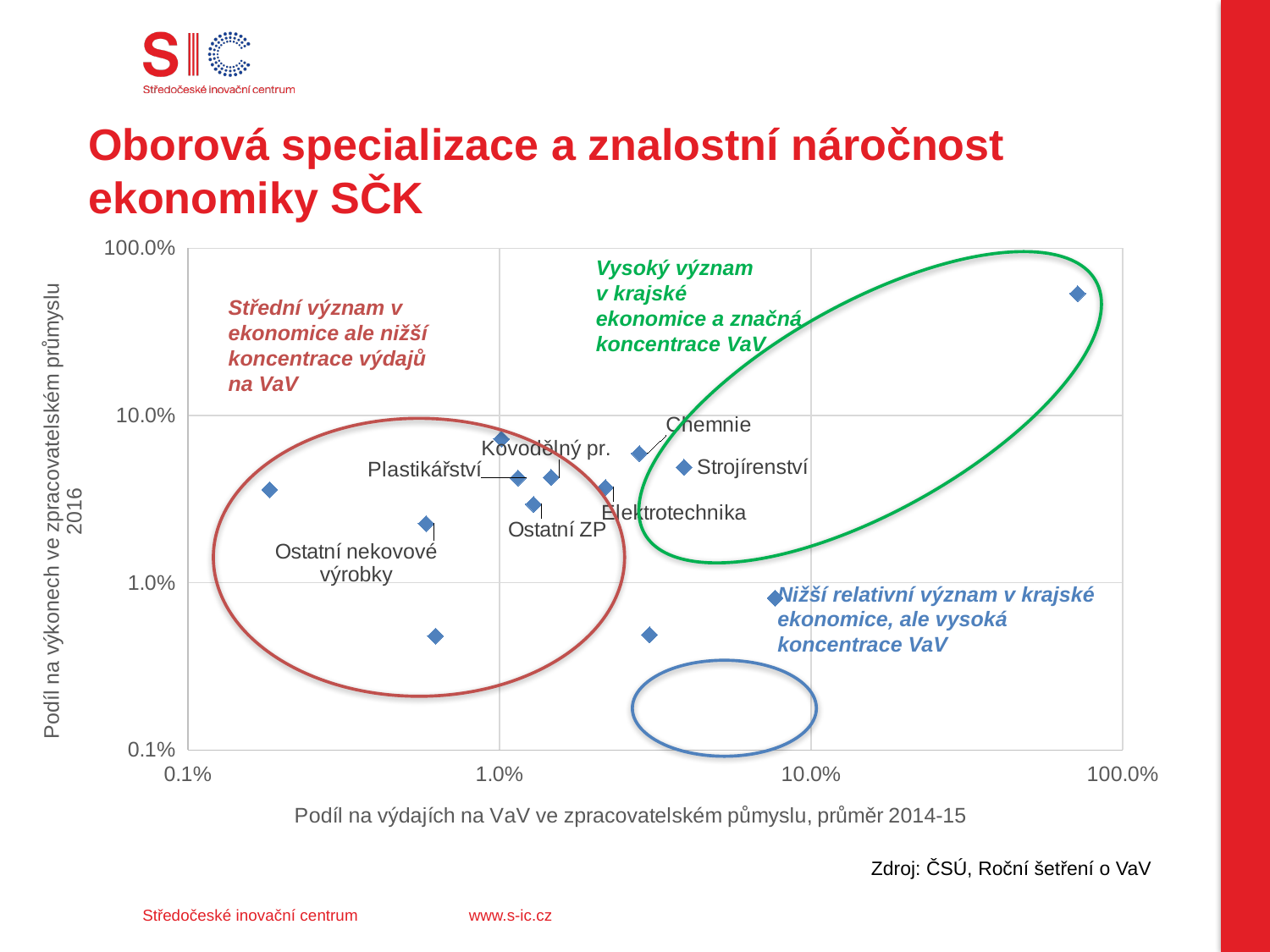
What source is cited below the chart? ČSÚ, Roční šetření o VaV Is the value on the horizontal axis for Elektrotechnika greater or less than 1.0%? greater Is the value on the vertical axis (Podíl na výkonech ve zpracovatelském průmyslu 2016) for Strojírenství greater or less than 1.0%? greater Which has the larger value on the vertical axis (Podíl na výkonech): Chemnie or Ostatní ZP? Chemnie Is the value on the vertical axis for Plastikářství greater or less than 1.0%? greater Which has the larger value on the horizontal axis (Podíl na výdajích na VaV): Strojírenství or Ostatní nekovové výrobky? Strojírenství Which has the larger value on the horizontal axis: Chemnie or Plastikářství? Chemnie What is the title of the horizontal axis of the chart? Podíl na výdajích na VaV ve zpracovatelském půmyslu, průměr 2014-15 What kind of chart is shown on the slide? scatter chart